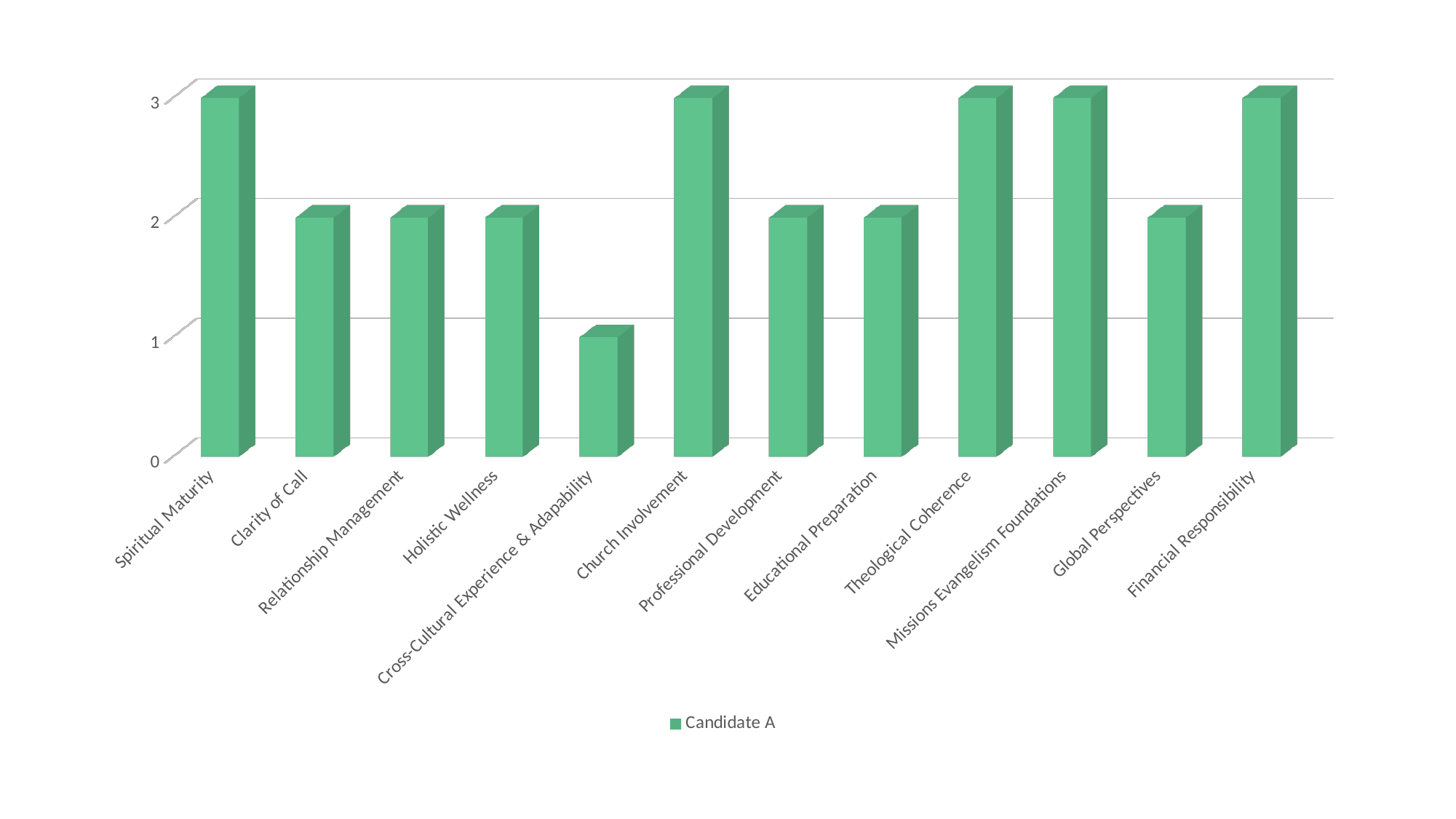
Is the value for Clarity of Call greater or less than 3? less How many categories are shown on the x axis? 12 How many series does the legend list? 1 What is the value for Spiritual Maturity? 3 What is the name of the series shown in the legend? Candidate A What is the value for Global Perspectives? 2 Which is larger, the value for Church Involvement or the value for Professional Development? Church Involvement What is the difference between the value for Theological Coherence and the value for Cross-Cultural Experience & Adaptability? 2 What is the difference between the value for Financial Responsibility and the value for Educational Preparation? 1 What kind of chart is shown on the slide? bar chart Which category has the lowest value? Cross-Cultural Experience & Adaptability What is the value for Cross-Cultural Experience & Adaptability? 1